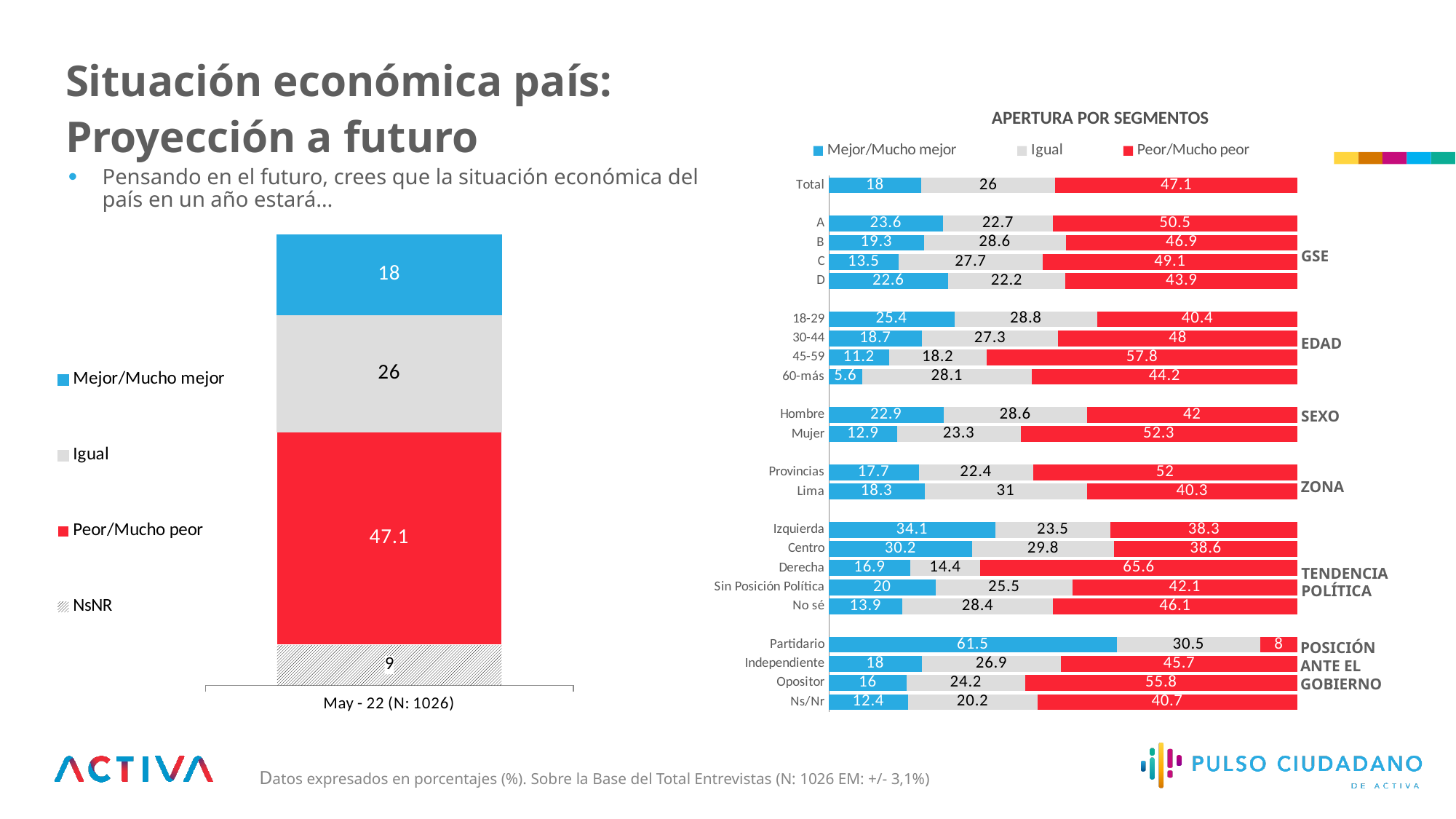
In the APERTURA POR SEGMENTOS chart, what is the total of the Partidario bar? 100 In the APERTURA POR SEGMENTOS chart, what is the Mejor/Mucho mejor value for Partidario? 61.5 In the APERTURA POR SEGMENTOS chart, which segment has the highest Peor/Mucho peor value? Derecha In the APERTURA POR SEGMENTOS chart, which segment has the lowest Mejor/Mucho mejor value? 60-más What kind of chart is the left chart (May - 22)? Stacked bar chart In the left chart (May - 22), what is the value for NsNR? 9 In the APERTURA POR SEGMENTOS chart, what is the difference between the Peor/Mucho peor values for Mujer and Hombre? 10.3 In the APERTURA POR SEGMENTOS chart, what is the Igual value for Lima? 31 How many series does the legend of the APERTURA POR SEGMENTOS chart list? 3 How many series does the legend of the left chart list? 4 In the APERTURA POR SEGMENTOS chart, which has a larger Mejor/Mucho mejor value, Izquierda or Centro? Izquierda In the left chart (May - 22), what is the value for Peor/Mucho peor? 47.1